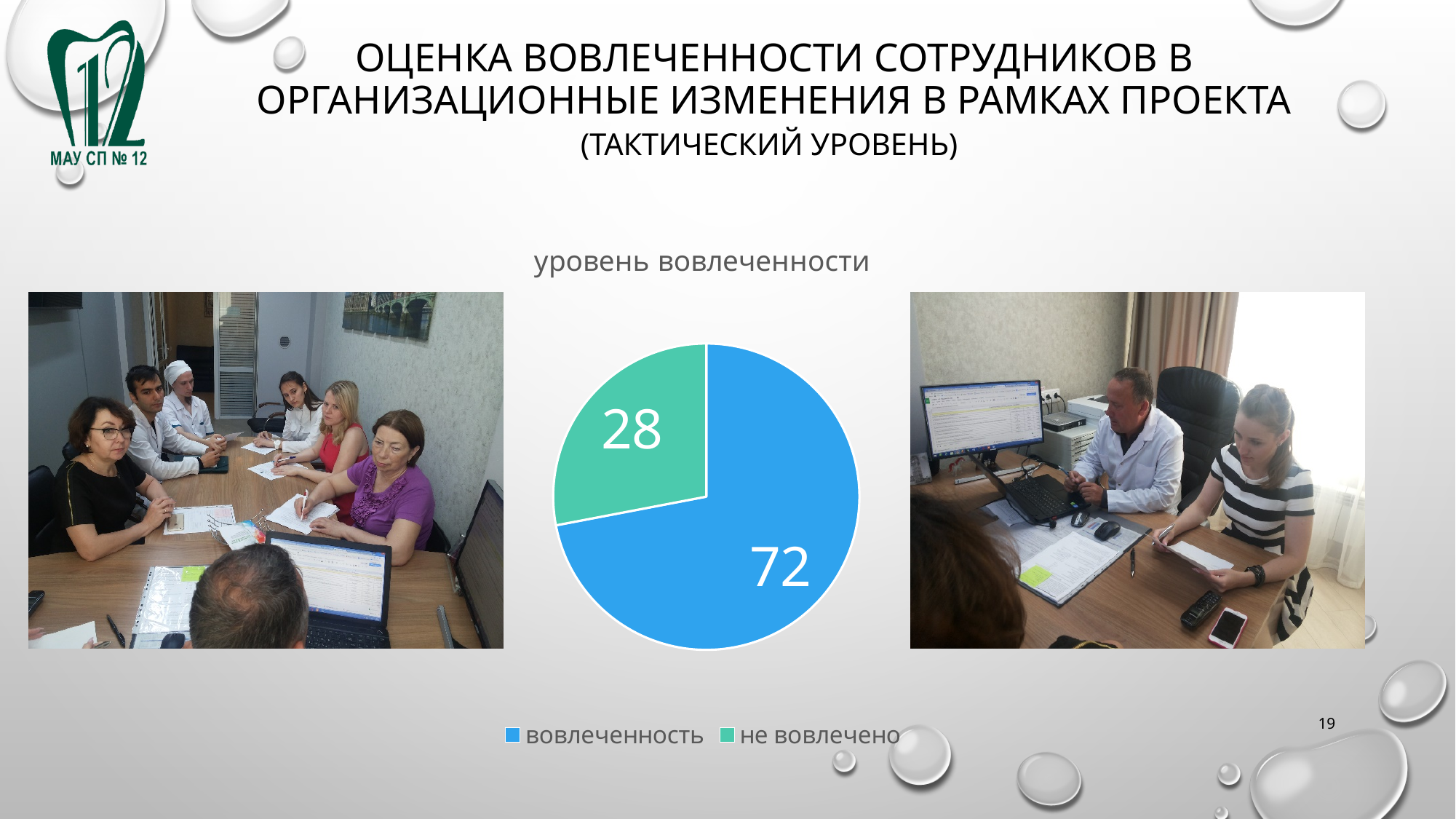
What is the total of all slices in the pie chart? 100 Which is larger: the value for "вовлеченность" or for "не вовлечено"? вовлеченность How many entries does the legend list? 2 What is the difference between the values for "вовлеченность" and "не вовлечено"? 44 Which category has the largest slice in the pie chart? вовлеченность What is the title of the chart? уровень вовлеченности What type of chart is shown on the slide? pie chart Which category has the smallest slice in the pie chart? не вовлечено What share of the pie does the "не вовлечено" slice represent? 28 What is the value for "вовлеченность" in the pie chart? 72 How many slices does the pie chart have? 2 What is the value for "не вовлечено" in the pie chart? 28